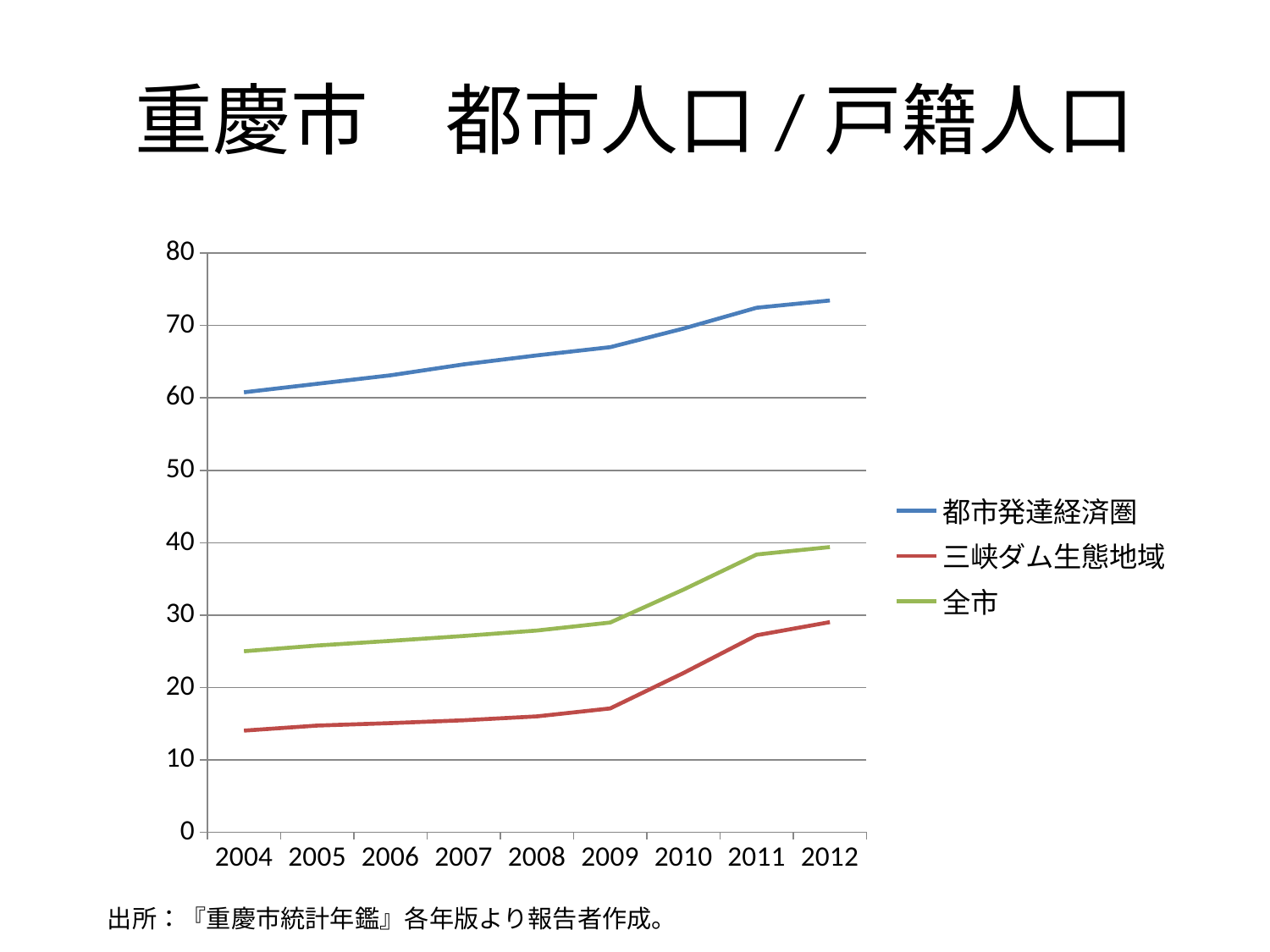
How many years are shown on the x axis? 9 Is the value for 都市発達経済圏 in 2009 greater or less than 70? less How many series does the legend list? 3 Which series has the highest value in 2012? 都市発達経済圏 Does the value for 全市 rise or fall from 2004 to 2012? rise Is the value for 三峡ダム生態地域 in 2004 greater or less than 20? less Is the value for 全市 in 2010 greater or less than 30? greater What kind of chart is shown on the slide? line chart Which series has the lowest value in 2004? 三峡ダム生態地域 In 2004, which is larger: the value for 全市 or the value for 三峡ダム生態地域? 全市 What is the title of the slide? 重慶市 都市人口 / 戸籍人口